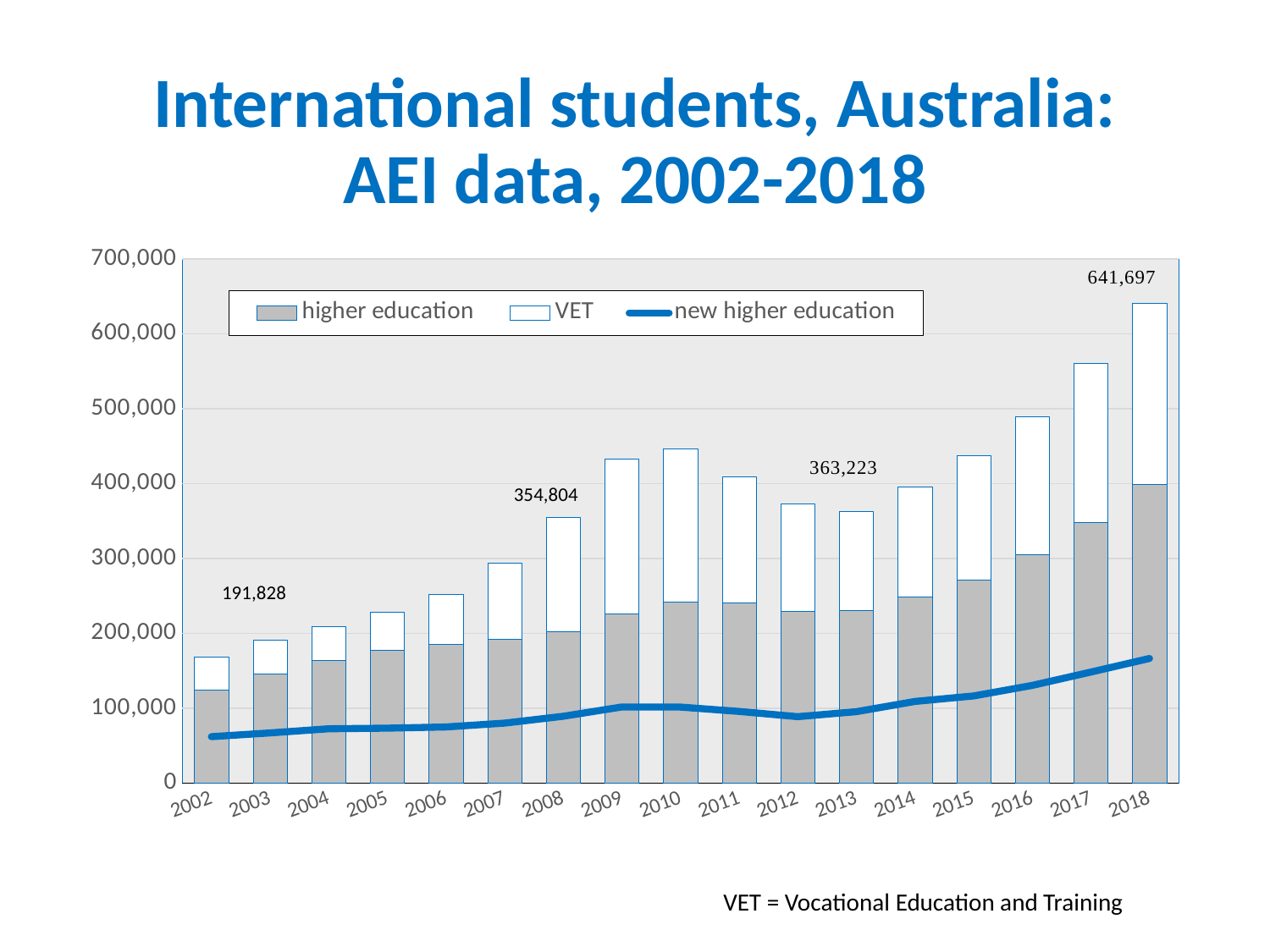
Which year has the lowest total bar? 2002 What is the difference between the 2018 total (641,697) and the 2002 total (191,828)? 449,869 What is the total number of international students shown for 2018? 641,697 How many years are shown on the x axis? 17 Which year has the highest total bar? 2018 Is the higher education value for 2015 greater or less than 300,000? less Is the total bar for 2010 greater or less than 400,000? greater What is the total number of international students shown for 2008? 354,804 What is the total number of international students shown for 2002? 191,828 Which series is drawn as a line rather than bars? new higher education How many series does the legend list? 3 Does the 'new higher education' line generally rise or fall from 2002 to 2018? rise